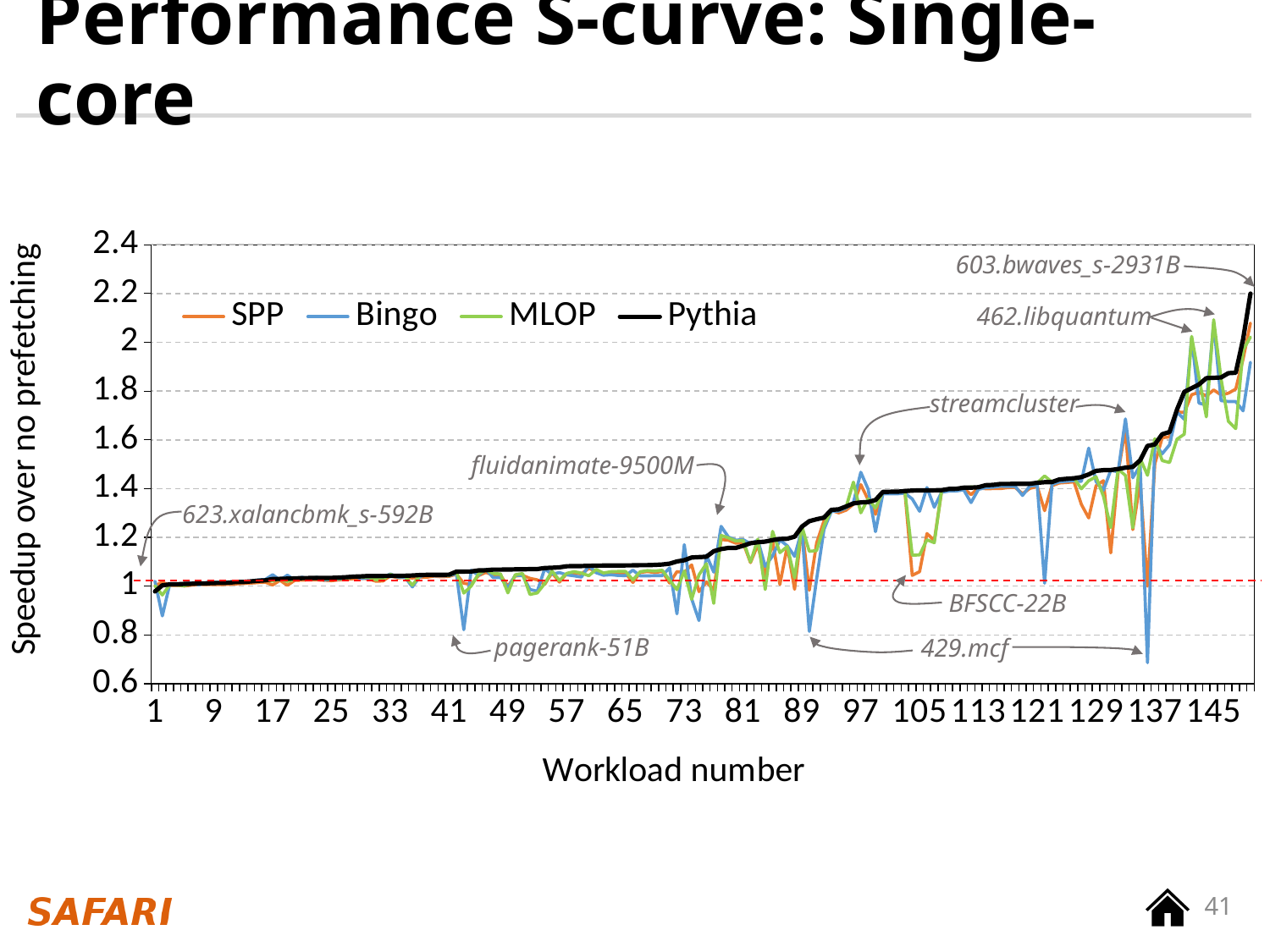
Which series reaches the highest value at the rightmost workload? Pythia Which series has the lowest point anywhere on the chart? Bingo What kind of chart is shown on the slide? line chart Is the lowest Bingo value on the chart (at the 429.mcf dip) greater or less than 0.8? less Is the Pythia value at workload 97 greater or less than 1.2? greater Is the Bingo value at the pagerank-51B dip greater or less than 1? less Which series are listed in the legend? SPP, Bingo, MLOP, Pythia At the rightmost workload, which is larger: the Pythia value or the Bingo value? Pythia At what y-axis value is the red dashed horizontal line drawn? 1 How many series does the legend list? 4 Does the Pythia line rise or fall as the workload number increases? rise